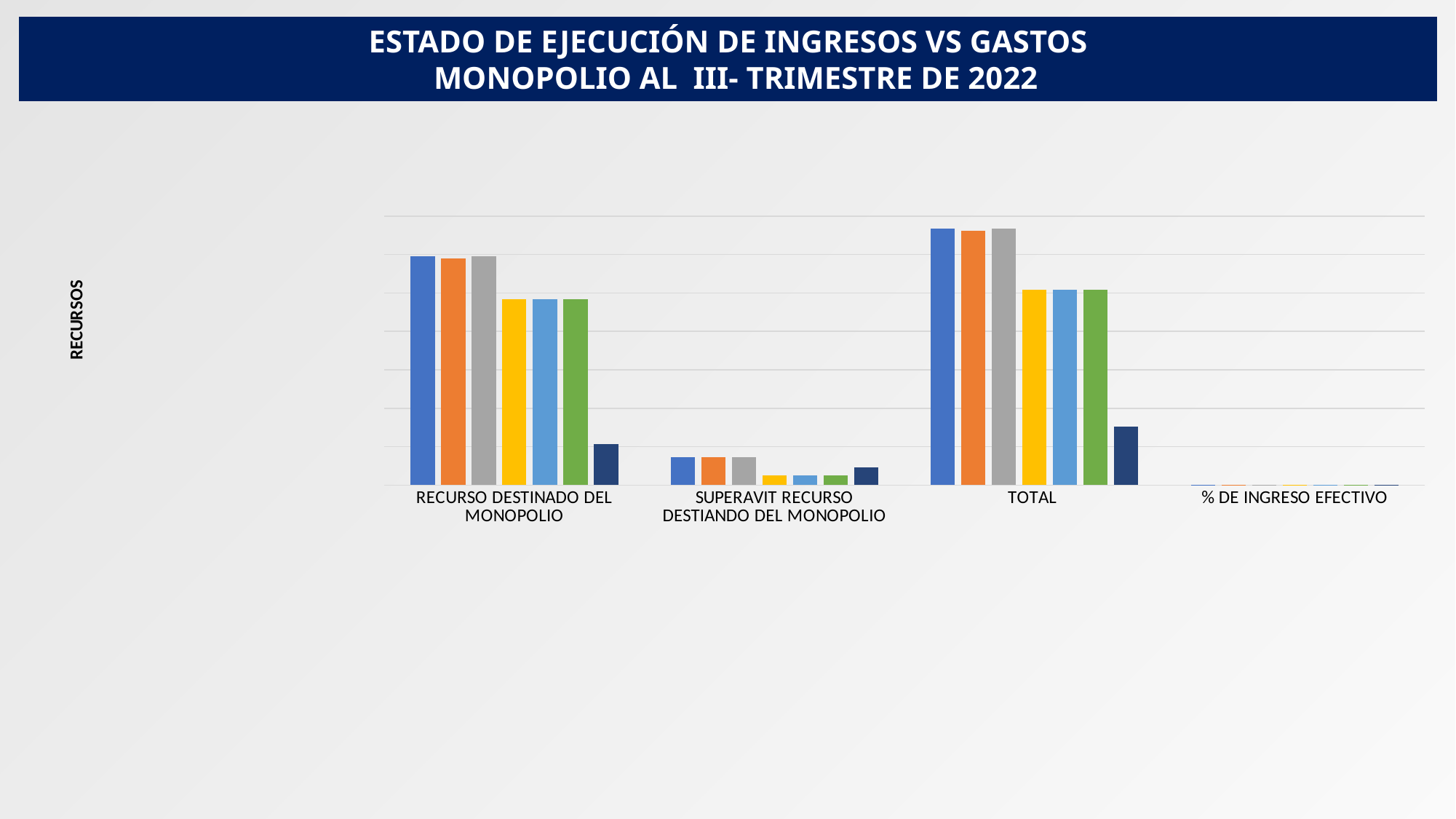
Within the TOTAL category, is the yellow bar larger or smaller than the orange bar? smaller What is the title of the chart on the slide? ESTADO DE EJECUCIÓN DE INGRESOS VS GASTOS MONOPOLIO AL III- TRIMESTRE DE 2022 What is the label on the vertical axis of the chart? RECURSOS Is the blue bar for TOTAL larger or smaller than the blue bar for SUPERAVIT RECURSO DESTIANDO DEL MONOPOLIO? larger Which category has the tallest bars in the chart? TOTAL Is the dark navy bar for RECURSO DESTINADO DEL MONOPOLIO larger or smaller than the dark navy bar for TOTAL? smaller How many categories are shown along the x axis of the chart? 4 What kind of chart is shown on the slide? bar chart Within the RECURSO DESTINADO DEL MONOPOLIO category, which colour bar is the shortest? dark navy Which category has the smallest bars in the chart? % DE INGRESO EFECTIVO How many bars are plotted for the TOTAL category? 7